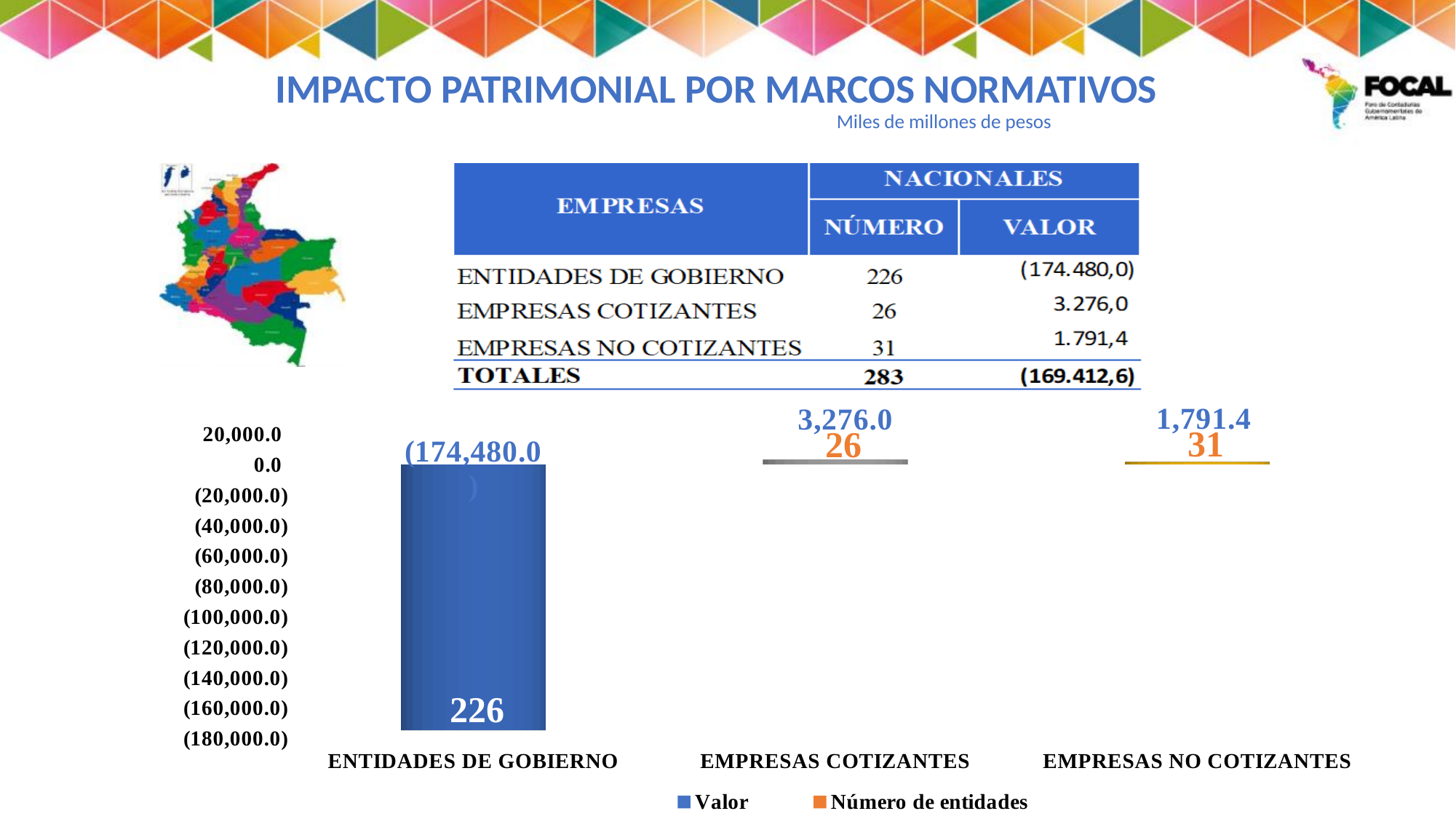
What is the difference between the Número de entidades for EMPRESAS NO COTIZANTES and EMPRESAS COTIZANTES? 5 What is the Número de entidades value for ENTIDADES DE GOBIERNO in the chart? 226 What is the Valor data label for EMPRESAS COTIZANTES in the chart? 3,276.0 What type of chart is shown on the slide? bar chart How many series does the chart legend list? 2 How many categories are shown on the x axis of the chart? 3 Which category has the highest Número de entidades in the chart? ENTIDADES DE GOBIERNO Which series is shown in blue in the chart legend? Valor Which category has the lowest Número de entidades in the chart? EMPRESAS COTIZANTES What is the Valor data label for EMPRESAS NO COTIZANTES in the chart? 1,791.4 What is the Número de entidades value for EMPRESAS NO COTIZANTES in the chart? 31 What is the Valor data label for ENTIDADES DE GOBIERNO in the chart? (174,480.0)